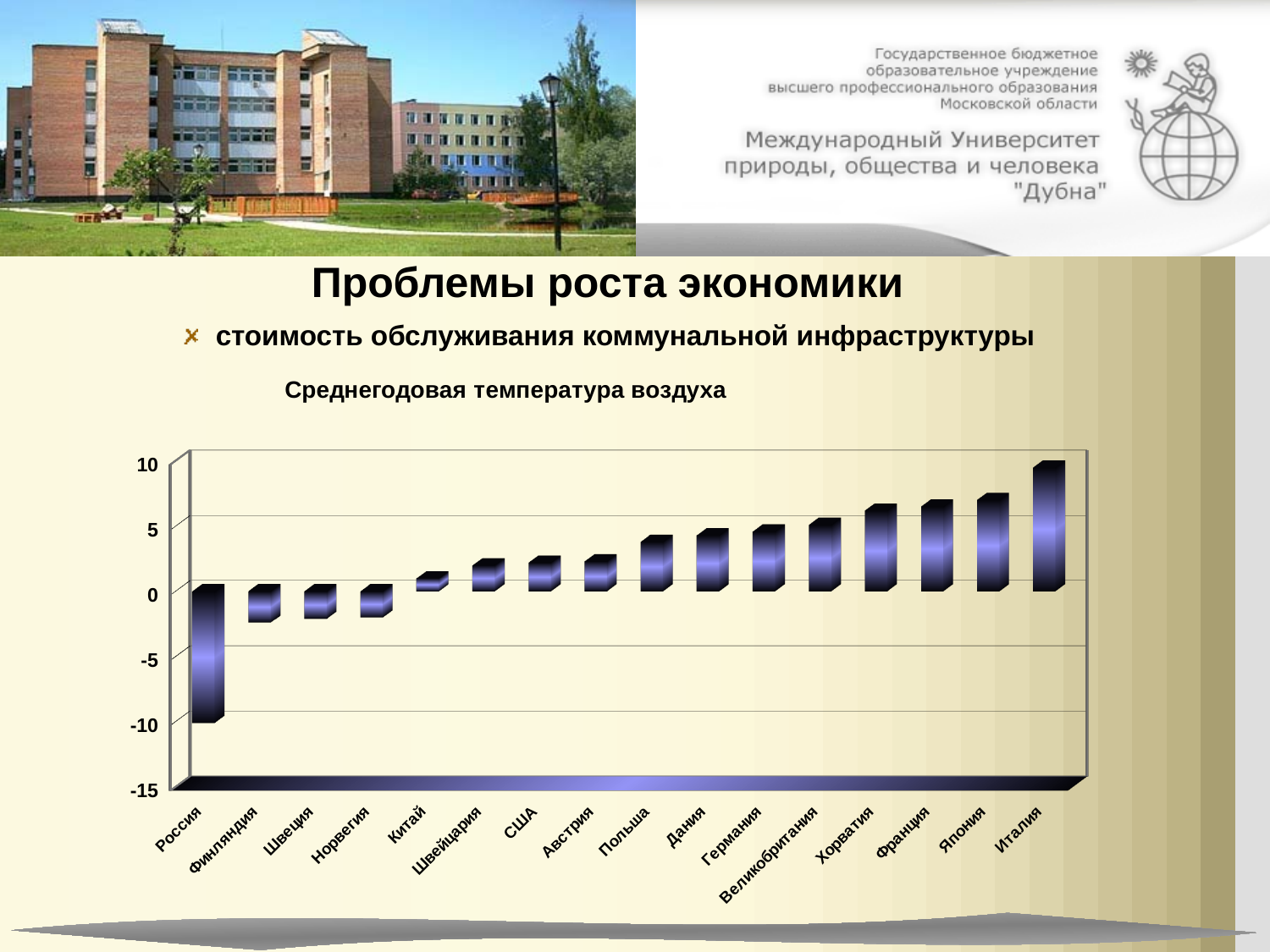
Is the value for Италия greater or less than 5? greater Is the value for Польша greater or less than 5? less How many countries are shown on the x axis of the chart? 16 What kind of chart is shown on the slide? bar chart Which country has the lowest average annual air temperature in the chart? Россия What is the title of the chart? Среднегодовая температура воздуха Is the value for Финляндия greater or less than 0? less Which has a lower value, Швеция or Германия? Швеция Which country has the highest average annual air temperature in the chart? Италия Do the values generally rise or fall from left to right along the x axis? rise Which has a higher value, Япония or Китай? Япония